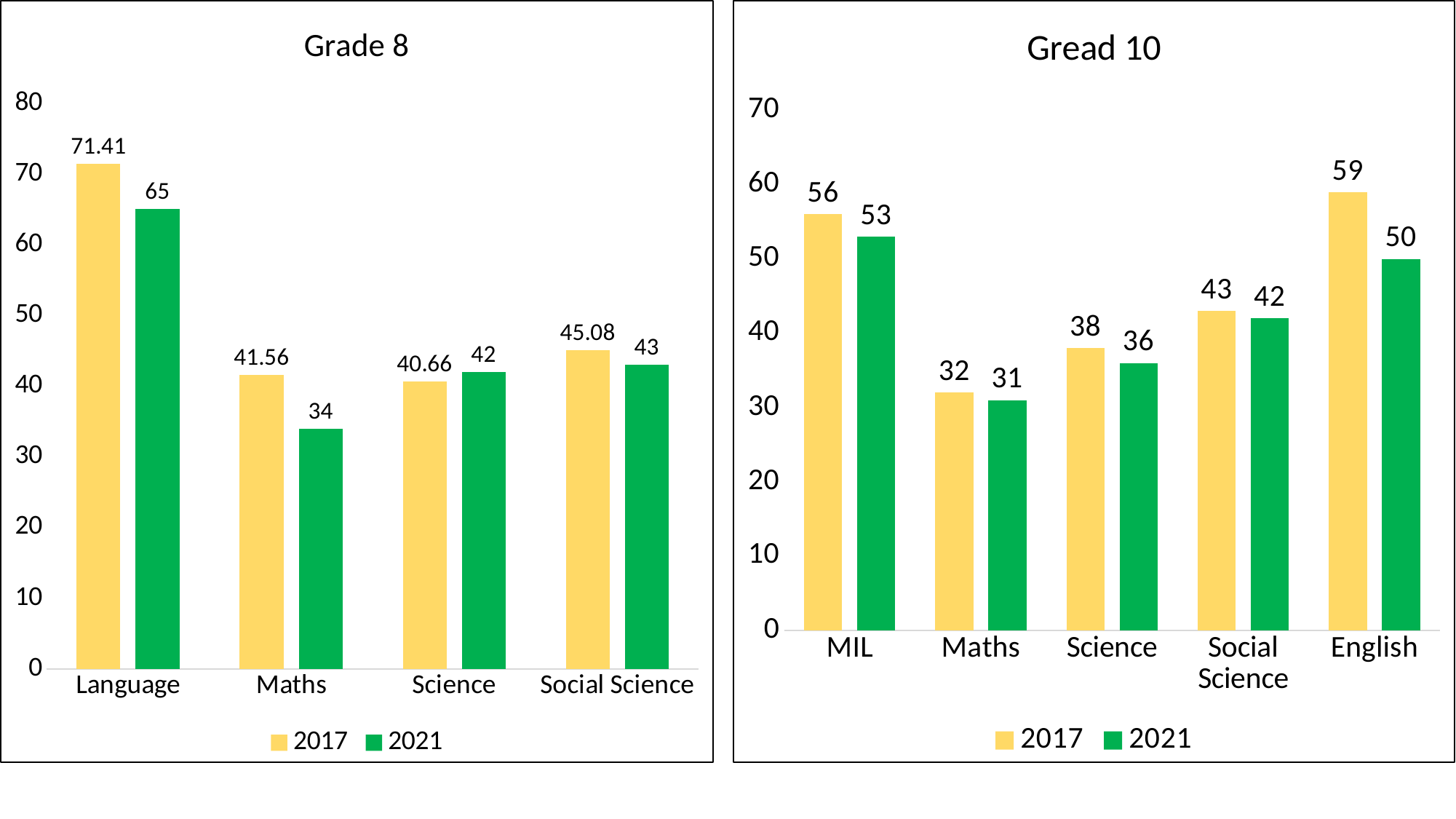
In the Grade 8 chart, what is the 2021 value for Maths? 34 How many subjects are shown in the Gread 10 chart? 5 In the Gread 10 chart, what is the 2017 value for English? 59 In the Grade 8 chart, what is the 2017 value for Language? 71.41 In the Grade 8 chart, which colour represents 2021? Green What kind of chart is the Gread 10 chart? Bar chart How many series does the legend of the Grade 8 chart list? 2 In the Gread 10 chart, which subject has the lowest 2021 value? Maths In the Grade 8 chart, which subject has the highest 2021 value? Language In the Grade 8 chart, which is larger for Science: the 2017 value or the 2021 value? 2021 In the Gread 10 chart, what is the 2021 value for Science? 36 In the Gread 10 chart, what is the difference between the 2017 and 2021 values for MIL? 3